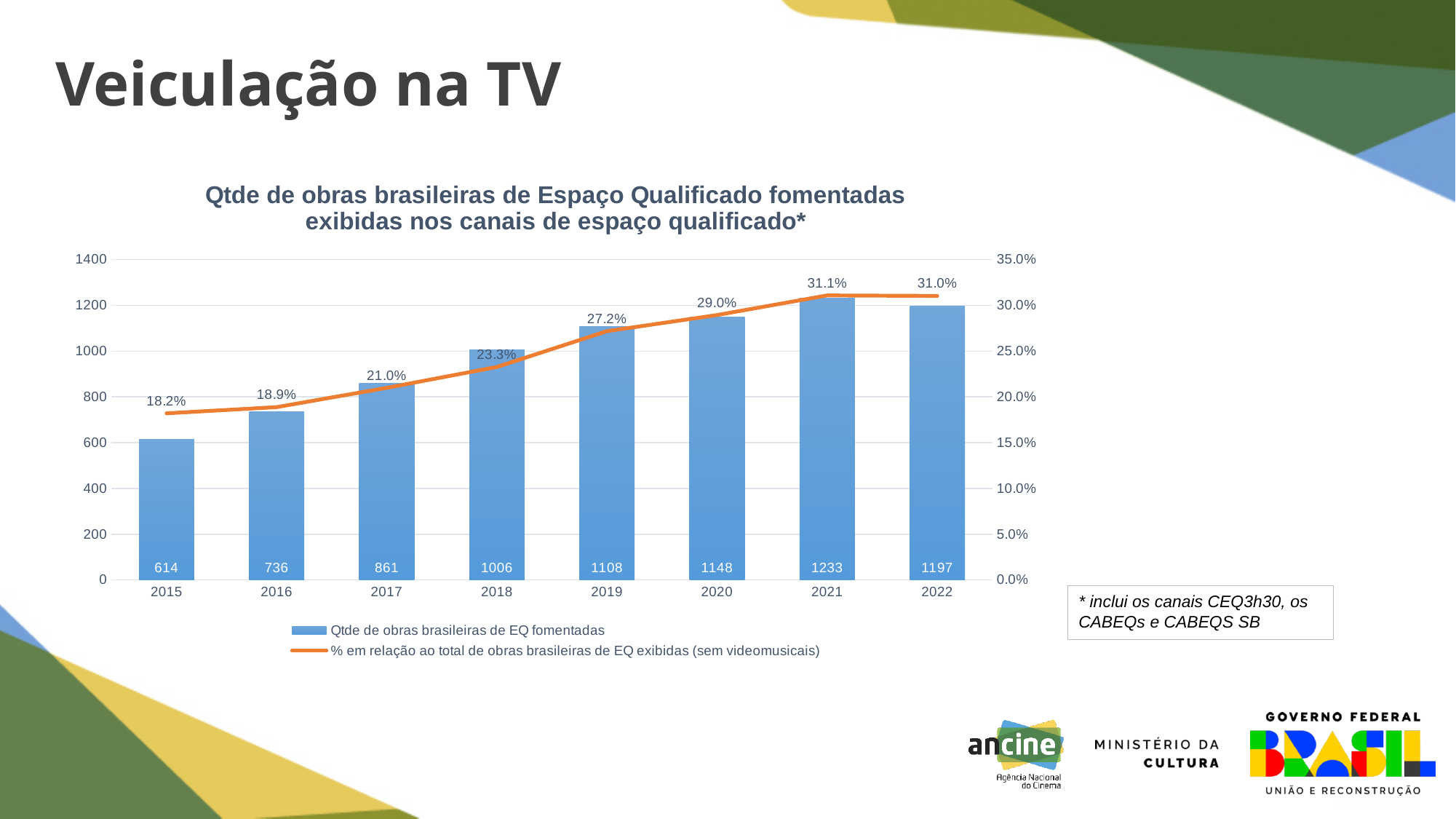
What percentage does the line series show for 2019? 27.2% What is the value of 'Qtde de obras brasileiras de EQ fomentadas' for 2018? 1006 Which year has the highest number of 'Qtde de obras brasileiras de EQ fomentadas'? 2021 What kind of chart is used for the 'Qtde de obras brasileiras de EQ fomentadas' series? bar chart Does the percentage line rise or fall from 2015 to 2021? rise Which year has a larger bar value, 2017 or 2019? 2019 How many years are shown on the x axis? 8 Which year has the lowest number of 'Qtde de obras brasileiras de EQ fomentadas'? 2015 What is the difference between the bar values for 2021 and 2022? 36 Is the bar value for 2016 greater or less than 800? less How many series does the legend list? 2 What colour is the line series in the chart? orange